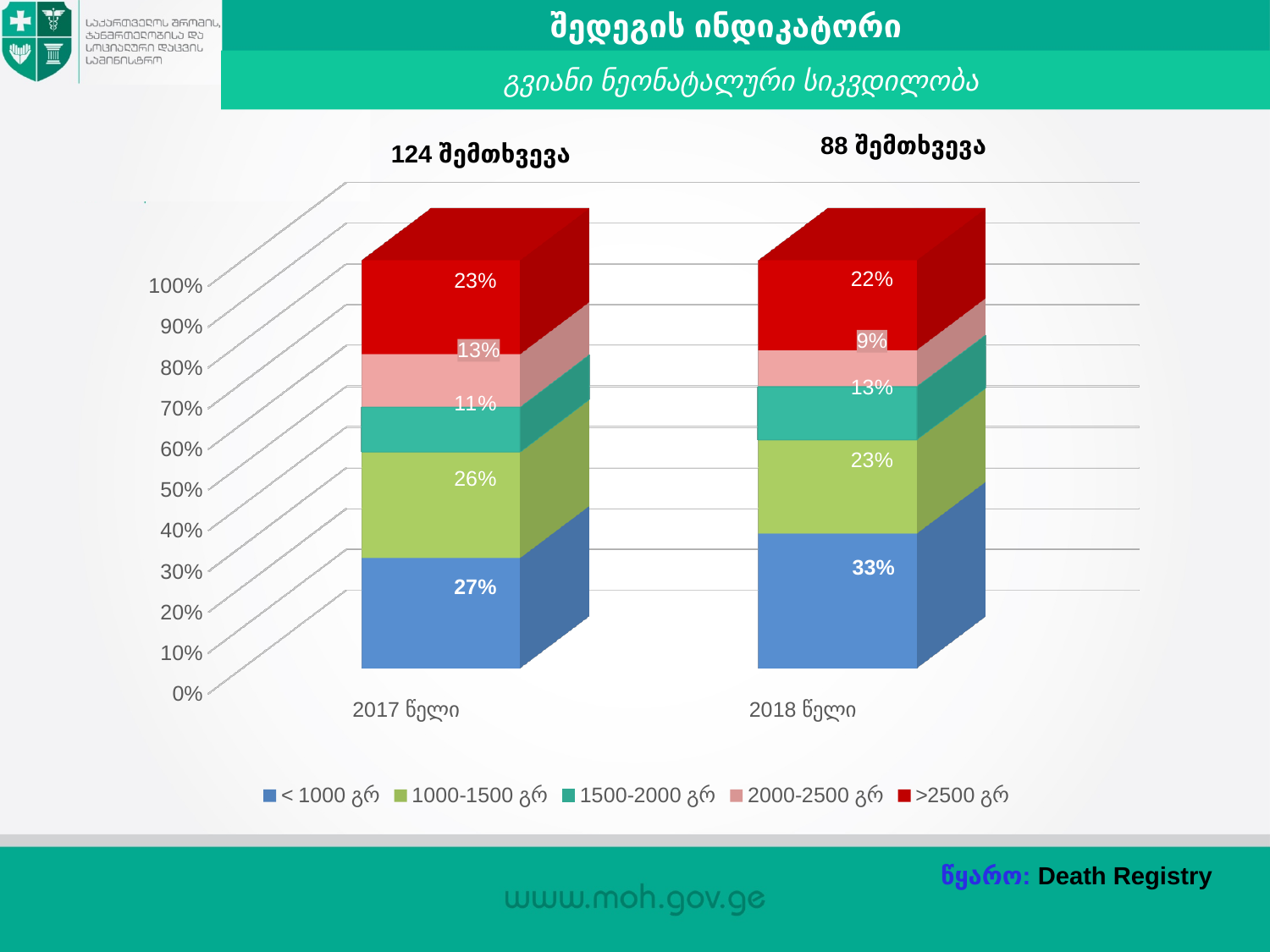
What is the value for 2000-2500 გრ in 2018 წელი? 9% What is the value for >2500 გრ in 2017 წელი? 23% How many categories are shown on the x axis? 2 How many series does the legend list? 5 What is the value for < 1000 გრ in 2017 წელი? 27% Which is larger, the 1500-2000 გრ value in 2017 წელი or in 2018 წელი? 2018 წელი Which series has the highest value in 2018 წელი? < 1000 გრ What is the value for 1000-1500 გრ in 2017 წელი? 26% What is the value for < 1000 გრ in 2018 წელი? 33% What kind of chart is shown on the slide? stacked bar chart What is the difference between the < 1000 გრ values for 2018 წელი and 2017 წელი? 6% Which series has the lowest value in 2017 წელი? 1500-2000 გრ